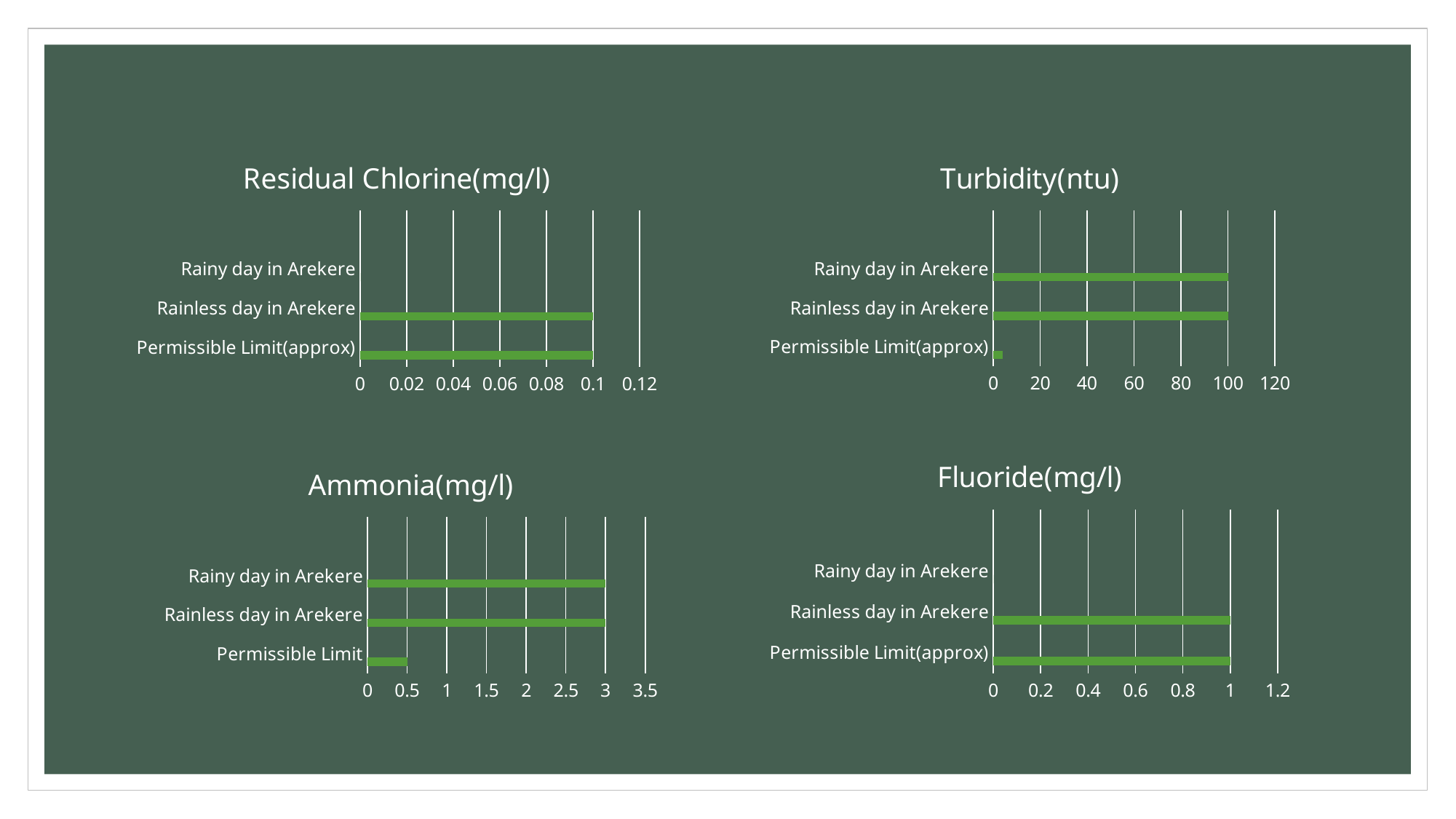
In the Fluoride(mg/l) chart, what is the value for Rainless day in Arekere? 1 In the Turbidity(ntu) chart, which category has the lowest value? Permissible Limit(approx) What kind of chart is the Fluoride(mg/l) chart? bar chart In the Ammonia(mg/l) chart, what is the value for Permissible Limit? 0.5 In the Residual Chlorine(mg/l) chart, what is the value for Rainless day in Arekere? 0.1 In the Ammonia(mg/l) chart, which is larger, Rainy day in Arekere or Permissible Limit? Rainy day in Arekere In the Turbidity(ntu) chart, what is the value for Rainy day in Arekere? 100 How many charts are shown on the slide? 4 In the Residual Chlorine(mg/l) chart, what is the value for Permissible Limit(approx)? 0.1 In the Ammonia(mg/l) chart, what is the difference between Rainless day in Arekere and Permissible Limit? 2.5 In the Turbidity(ntu) chart, is the value for Permissible Limit(approx) greater or less than 20? less In the Ammonia(mg/l) chart, what is the value for Rainy day in Arekere? 3